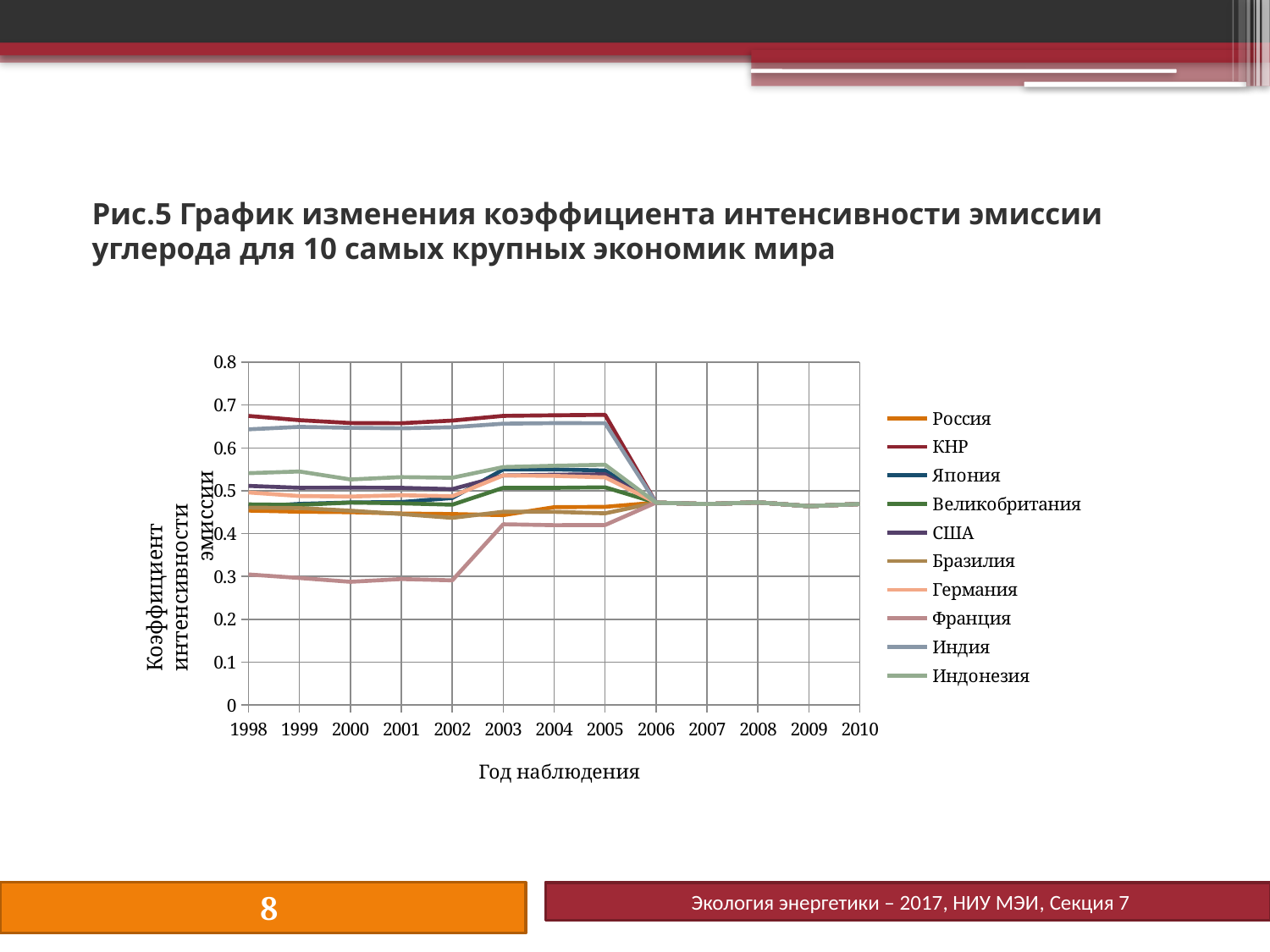
How many years are shown along the x axis? 13 Is the value for Франция in 1998 greater or less than 0.4? less What kind of chart is shown on the slide? line chart Does the value for Франция rise or fall from 2002 to 2003? rise Which series has the lowest value in 1998? Франция How many series does the legend list? 10 Is the value for КНР in 2005 greater or less than 0.6? greater What is the label of the x axis? Год наблюдения Is the value for Россия in 1998 greater or less than 0.5? less Which series has the highest value in 1998? КНР Does the value for КНР rise or fall from 2005 to 2006? fall Which is larger in 2000, the value for КНР or the value for Франция? КНР